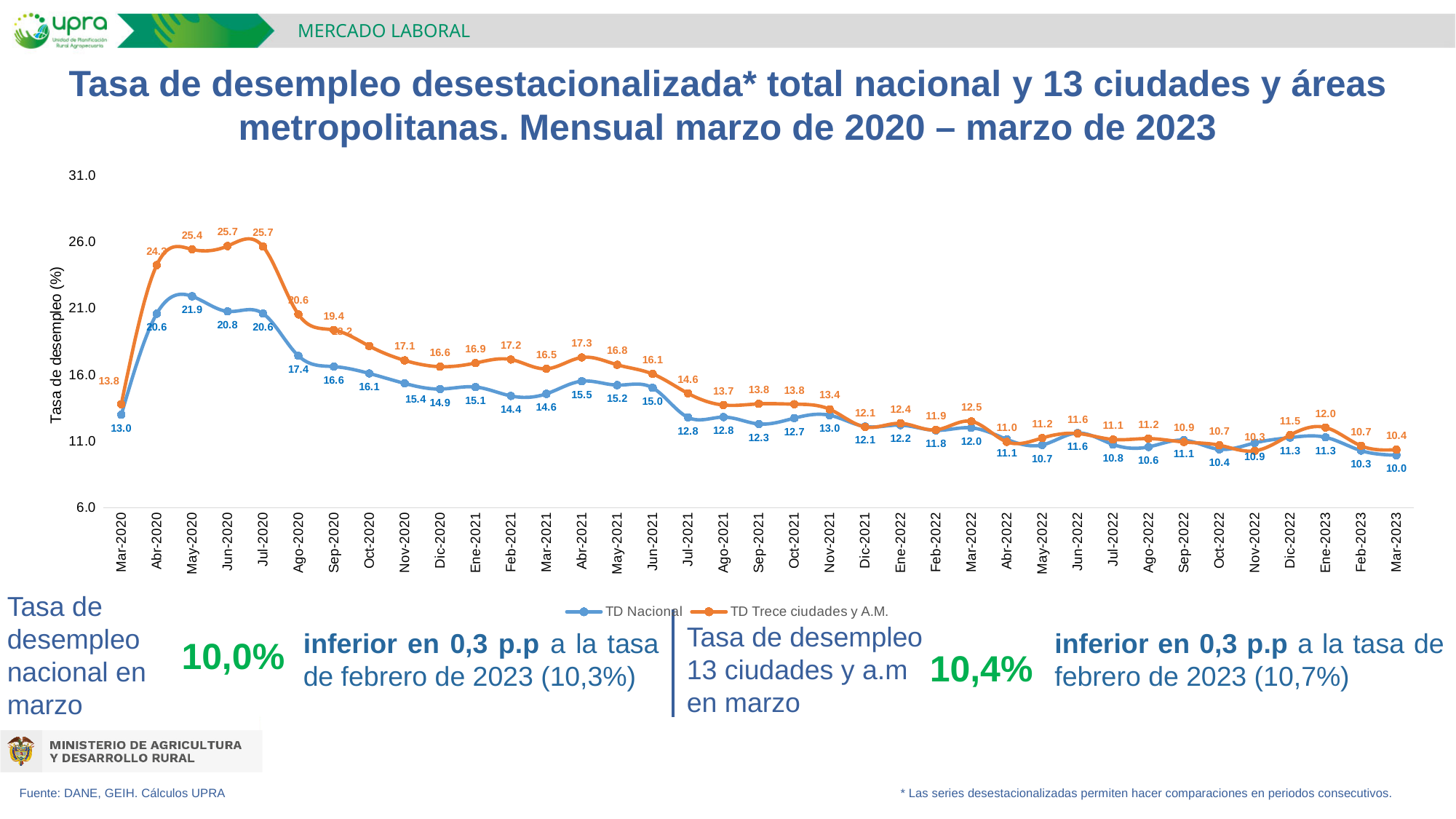
What is the difference between TD Nacional in Feb-2023 and Mar-2023? 0.3 Which series has the higher value in Abr-2021, TD Nacional or TD Trece ciudades y A.M.? TD Trece ciudades y A.M. In which month does TD Nacional reach its lowest value? Mar-2023 What is the value of TD Nacional in May-2020? 21.9 Overall, do the values of TD Nacional rise or fall from Jul-2020 to Mar-2023? Fall What is the label of the y axis? Tasa de desempleo (%) What is the difference between TD Trece ciudades y A.M. and TD Nacional in Jul-2020? 5.1 In which month does TD Nacional reach its highest value? May-2020 What is the value of TD Trece ciudades y A.M. in Mar-2023? 10.4 What is the value of TD Nacional in Mar-2023? 10.0 What type of chart is shown on the slide? Line chart How many series does the legend list? 2